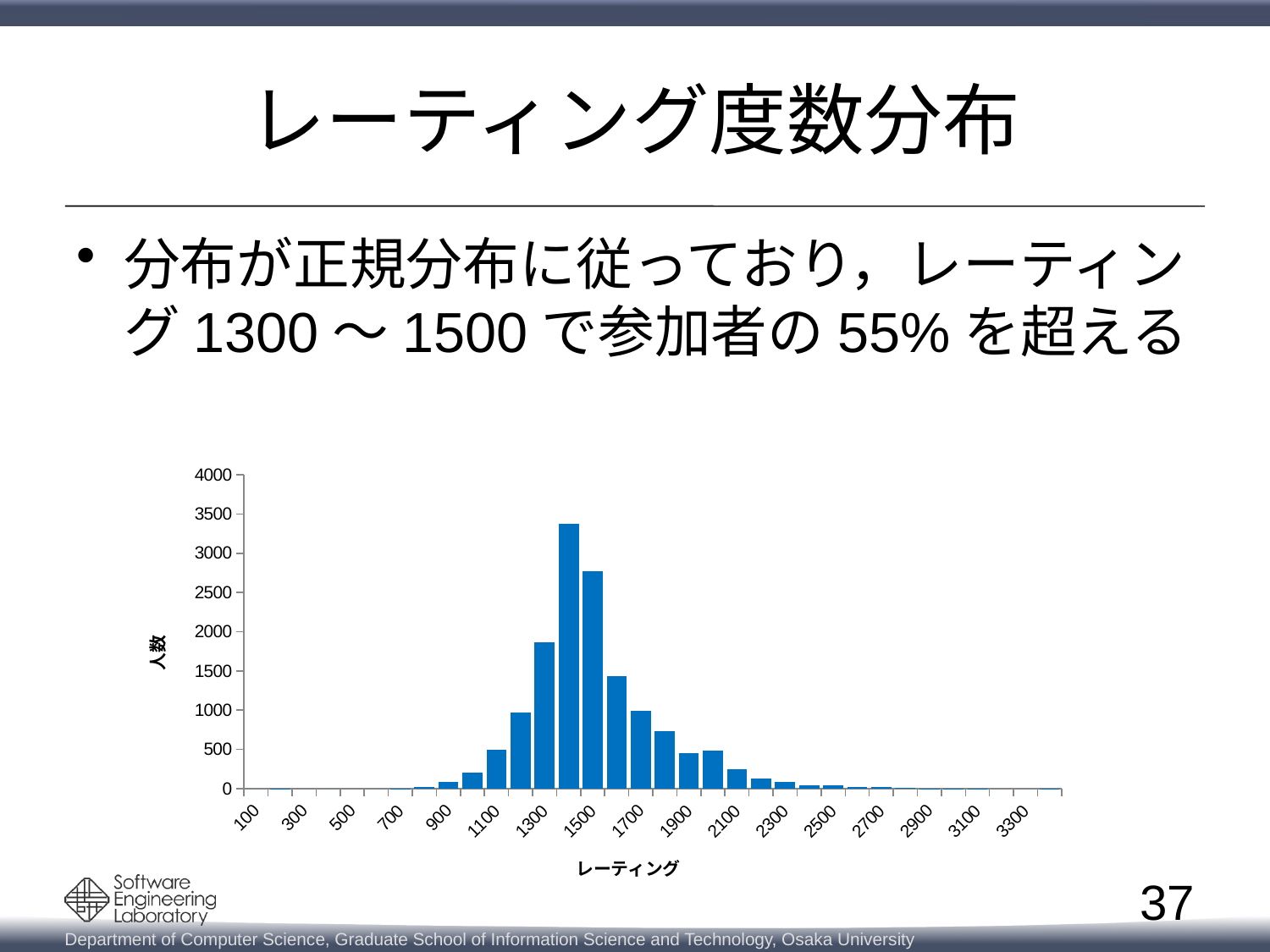
What is the title of the x axis of the chart? レーティング Is the value of the tallest bar greater or less than 3000? greater Is the value of the tallest bar greater or less than 3500? less Is the value for rating 1300 greater or less than 1500? greater Which is larger, the value for rating 1300 or the value for rating 1500? 1500 What is the title of the y axis of the chart? 人数 What kind of chart is shown on the slide? bar chart Do the values rise or fall along the x axis from rating 1500 to rating 2300? fall Which is larger, the value for rating 1300 or the value for rating 1700? 1300 How many labels are shown on the x axis of the chart? 17